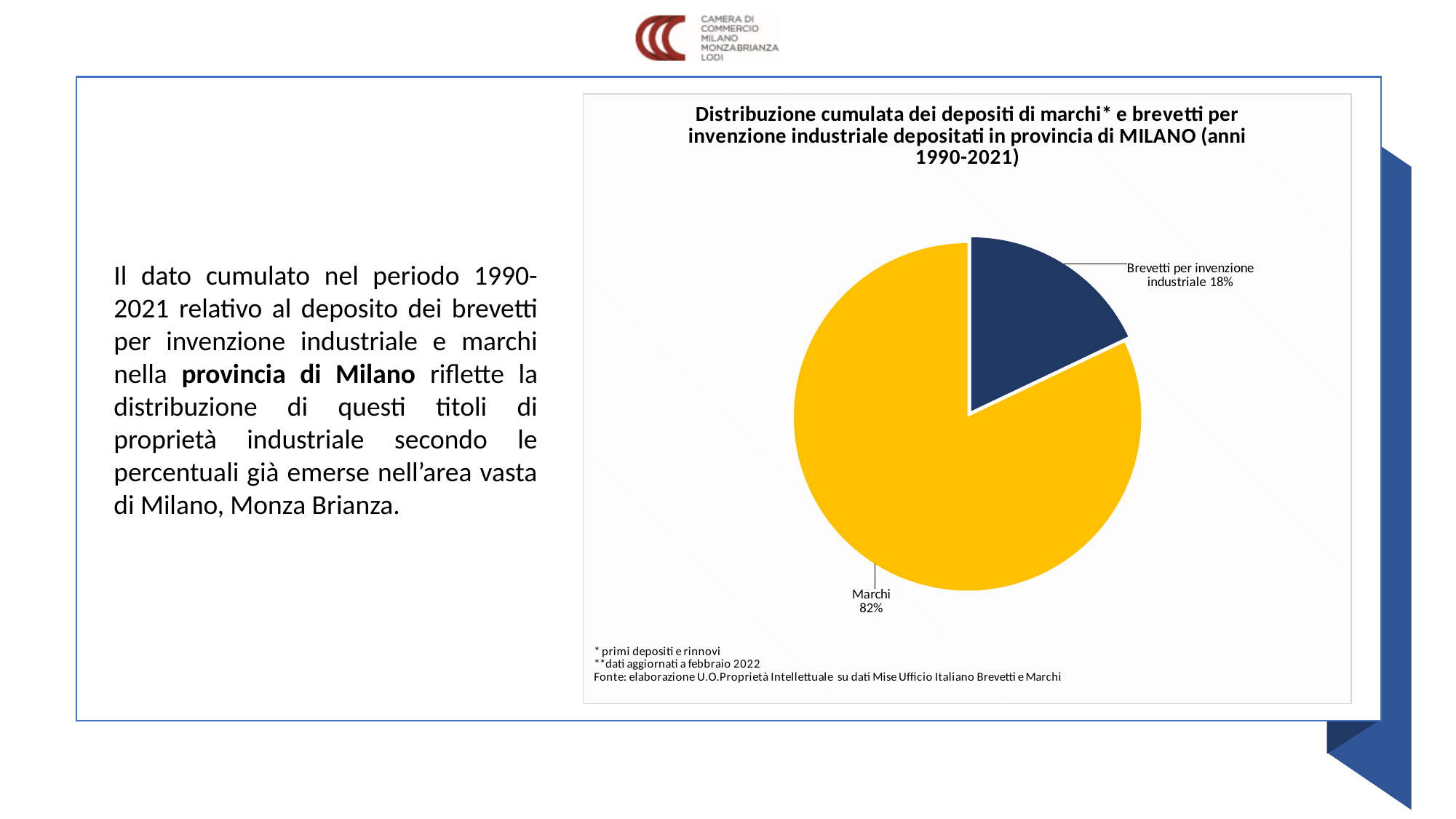
What share of the pie does Brevetti per invenzione industriale represent? 18% What colour is the Brevetti per invenzione industriale slice? dark blue What colour is the Marchi slice? yellow How many slices does the pie chart have? 2 Which slice of the pie is the largest? Marchi What share of the pie does Marchi represent? 82% What kind of chart is shown on the slide? pie chart Which is larger, the Marchi slice or the Brevetti per invenzione industriale slice? Marchi What is the difference in percentage points between the Marchi slice and the Brevetti per invenzione industriale slice? 64 Which slice of the pie is the smallest? Brevetti per invenzione industriale